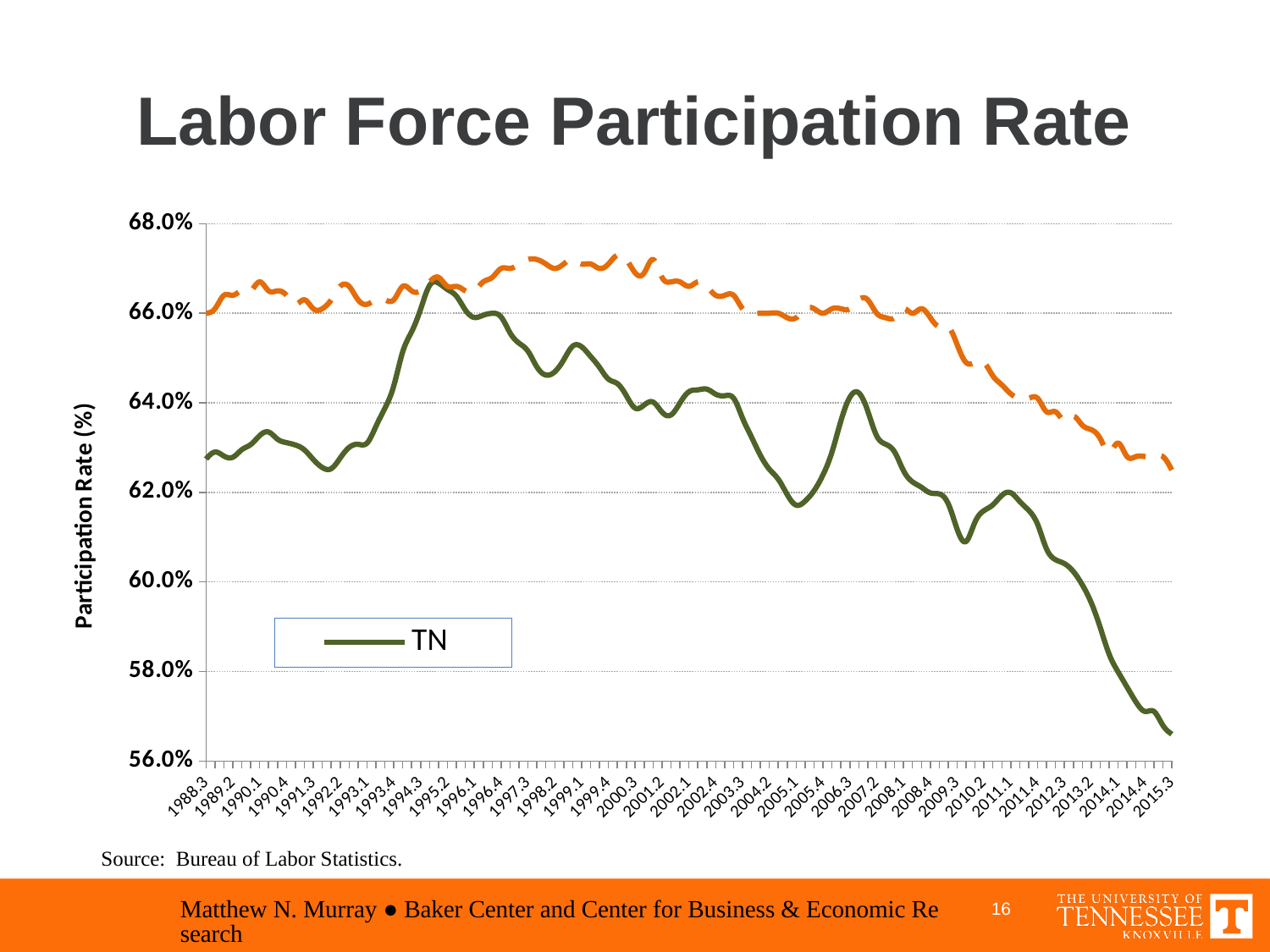
Is the TN value at 2009.3 greater or less than 60.0%? greater At 2015.3, which is higher: the solid green TN line or the orange dashed line? The orange dashed line How many series does the chart's legend list? 1 What is the title of the chart? Labor Force Participation Rate Is the TN value at 2015.3 greater or less than 58.0%? less Does the TN line rise or fall overall from 1988.3 to 2015.3? Fall What kind of chart is shown on the slide? Line chart Is the TN value at 2013.2 greater or less than 62.0%? less Does the TN line rise or fall from 2011.1 to 2015.3? Fall What series name appears in the chart's legend? TN